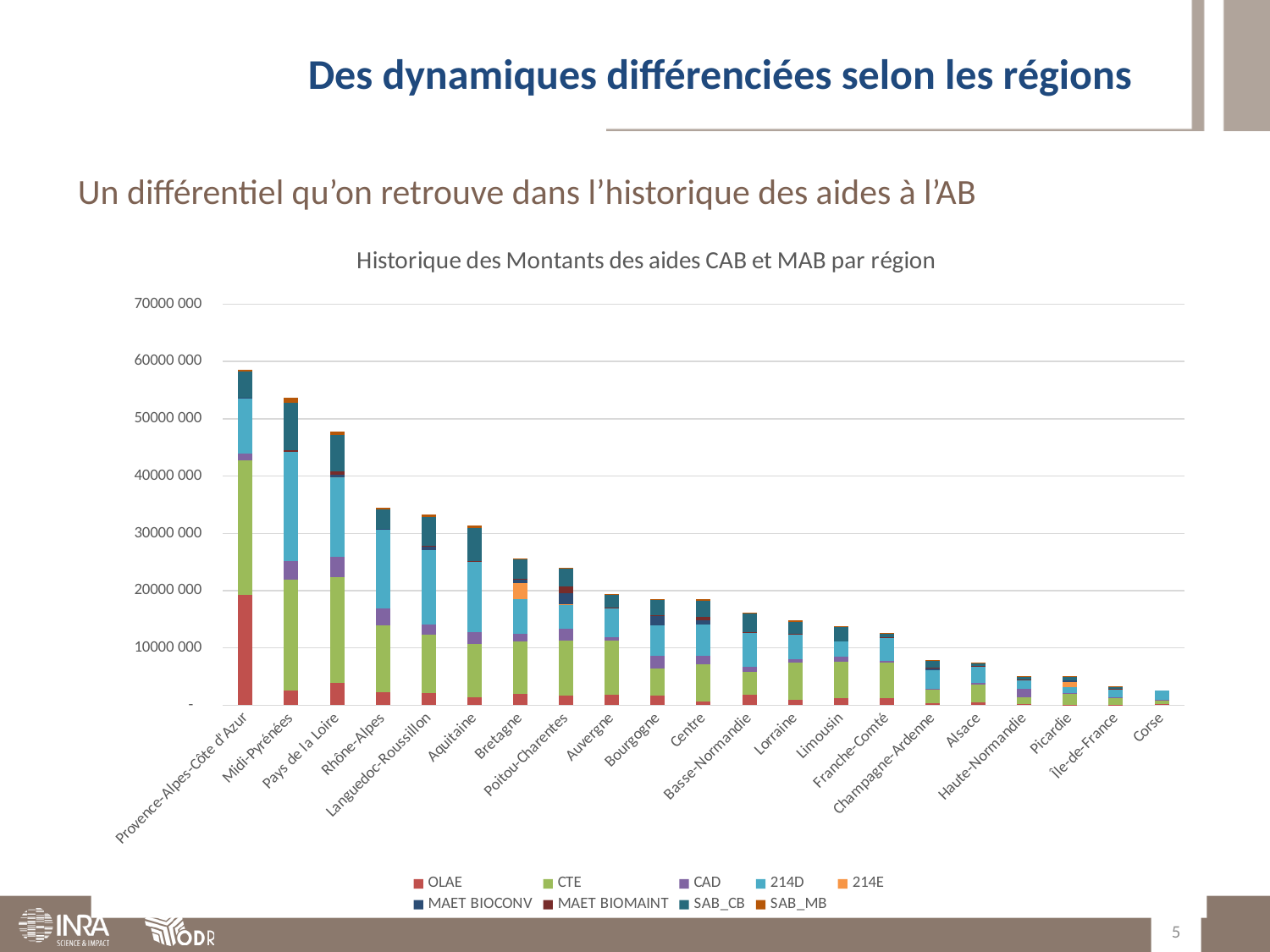
How many series does the chart legend list? 9 Is the total bar for Bretagne greater or less than 20000 000? greater Which region has the lowest total bar? Corse Which region has a larger total bar, Midi-Pyrénées or Pays de la Loire? Midi-Pyrénées Is the total bar for Rhône-Alpes greater or less than 40000 000? less What is the title of the chart? Historique des Montants des aides CAB et MAB par région Do the total bar heights rise or fall from left to right along the x axis? fall Is the total bar for Provence-Alpes-Côte d'Azur greater or less than 50000 000? greater Which region has the highest total bar? Provence-Alpes-Côte d'Azur What kind of chart is shown on the slide? Stacked bar chart Which series is listed first in the chart legend? OLAE How many regions are shown on the x axis of the chart? 21